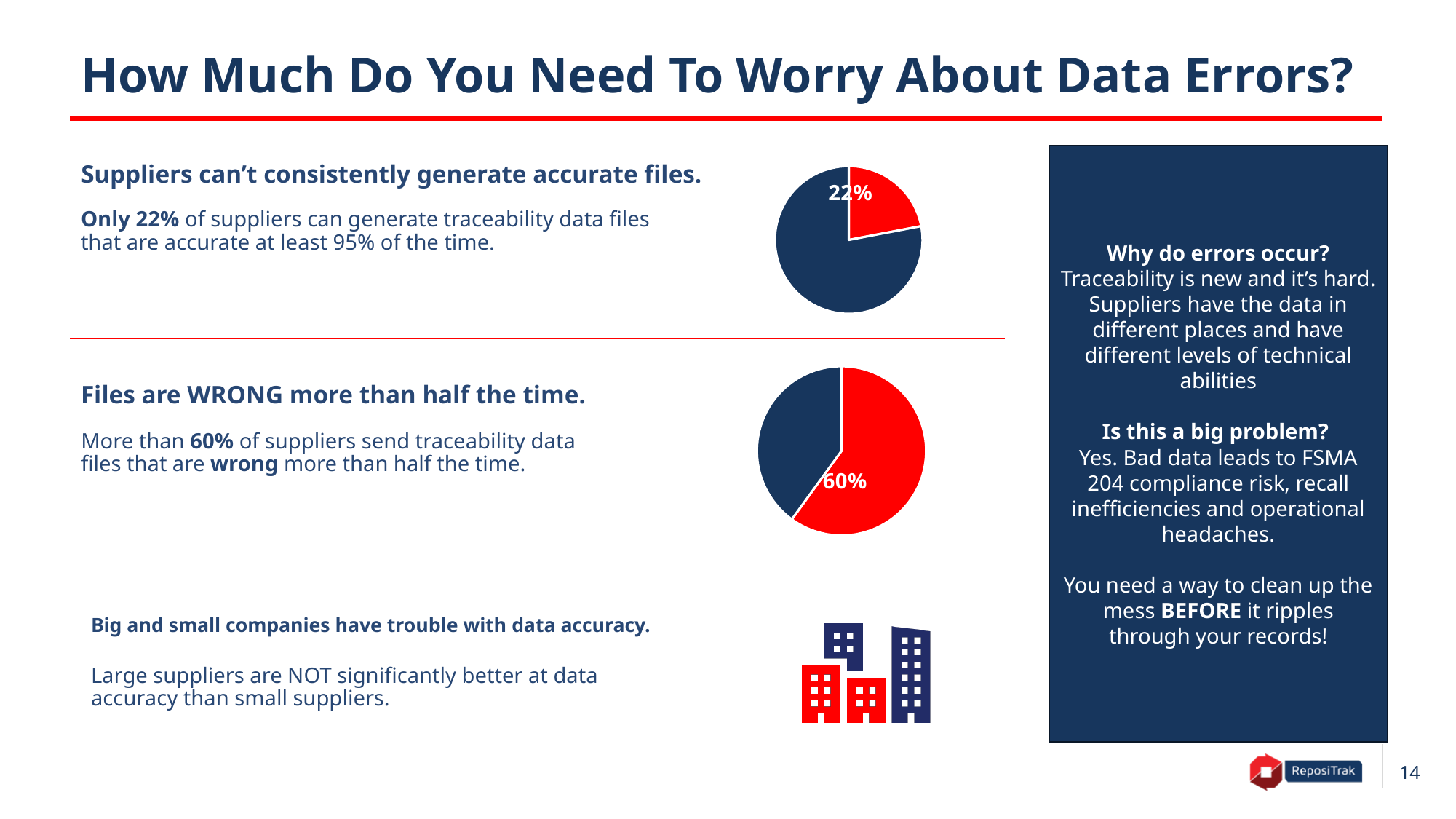
How many pie charts are shown on the slide? 2 In the bottom pie chart, what value is printed on the red slice? 60% In the top pie chart, what value is printed on the red slice? 22% In the top pie chart, which slice is larger, the red slice or the dark blue slice? The dark blue slice In the top pie chart, what share of the pie does the red slice represent? 22% How many slices does the bottom pie chart have? 2 What kind of chart is the top chart on the slide, next to the text about suppliers generating accurate files? Pie chart How many slices does the top pie chart have? 2 Which pie chart has the larger red slice, the top one or the bottom one? The bottom one In the bottom pie chart, which slice is larger, the red slice or the dark blue slice? The red slice In the bottom pie chart, what share of the pie does the red slice represent? 60% What kind of chart is the bottom chart on the slide, next to the text about files being wrong more than half the time? Pie chart